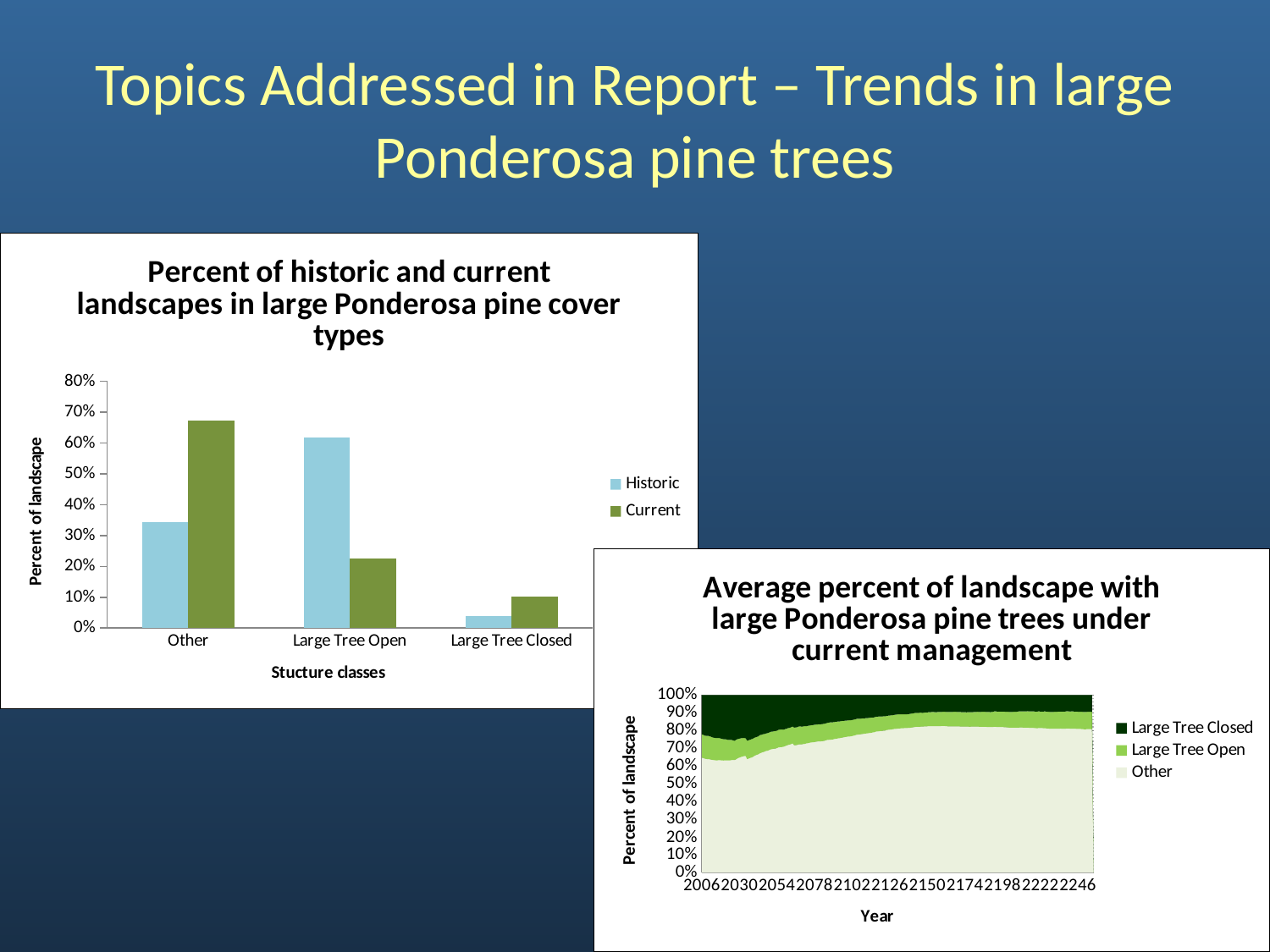
In the chart titled "Percent of historic and current landscapes in large Ponderosa pine cover types", which structure class has the lowest Historic value? Large Tree Closed How many series does the legend list in the chart titled "Average percent of landscape with large Ponderosa pine trees under current management"? 3 What is the x-axis label of the chart titled "Average percent of landscape with large Ponderosa pine trees under current management"? Year How many series does the legend list in the chart titled "Percent of historic and current landscapes in large Ponderosa pine cover types"? 2 In the chart titled "Percent of historic and current landscapes in large Ponderosa pine cover types", is the Current value for Other greater or less than 60%? greater In the chart titled "Percent of historic and current landscapes in large Ponderosa pine cover types", which structure class has the highest Current value? Other In the chart titled "Average percent of landscape with large Ponderosa pine trees under current management", which legend entry is shown in the darkest green? Large Tree Closed In the chart titled "Percent of historic and current landscapes in large Ponderosa pine cover types", is the Historic value for Large Tree Closed greater or less than 10%? less What kind of chart is the chart titled "Percent of historic and current landscapes in large Ponderosa pine cover types"? bar chart In the chart titled "Percent of historic and current landscapes in large Ponderosa pine cover types", is the Historic or the Current value larger for Large Tree Open? Historic How many structure classes are shown on the x axis of the chart titled "Percent of historic and current landscapes in large Ponderosa pine cover types"? 3 In the chart titled "Percent of historic and current landscapes in large Ponderosa pine cover types", is the Current value for Large Tree Open greater or less than 30%? less